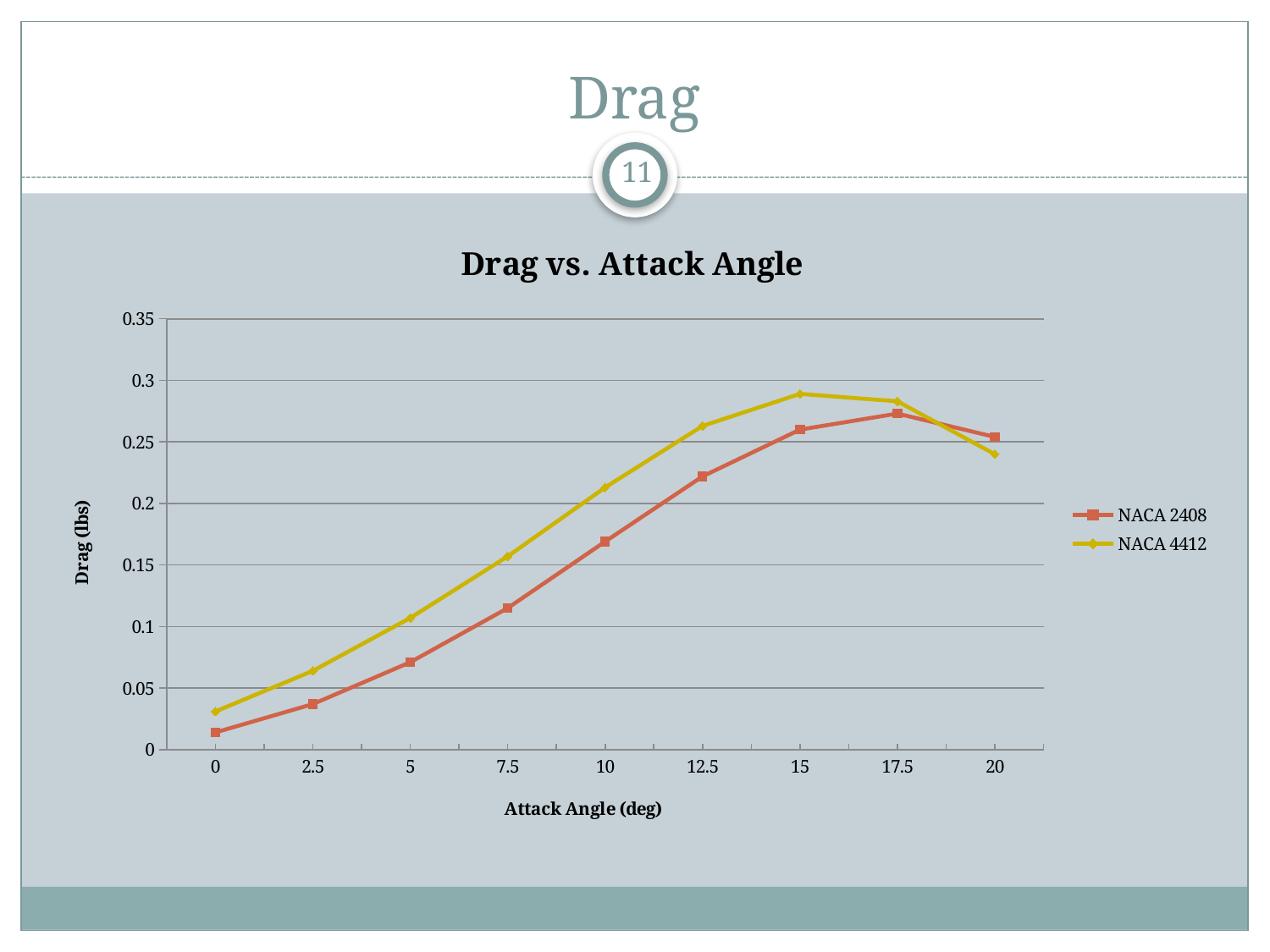
How many attack angle points are plotted for each series? 9 At which attack angle does the NACA 2408 series reach its highest drag? 17.5 Is the drag for NACA 2408 at an attack angle of 10 greater or less than 0.2? less Is the drag for NACA 4412 at an attack angle of 15 greater or less than 0.25? greater What is the title of the chart? Drag vs. Attack Angle How many series does the legend list? 2 Is the drag for NACA 2408 at an attack angle of 5 greater or less than 0.1? less What kind of chart is shown on the slide? Line chart At which attack angle does the NACA 4412 series reach its highest drag? 15 At an attack angle of 10, which series has the higher drag, NACA 2408 or NACA 4412? NACA 4412 At which attack angle is the drag for NACA 2408 lowest? 0 At an attack angle of 20, which series has the higher drag, NACA 2408 or NACA 4412? NACA 2408